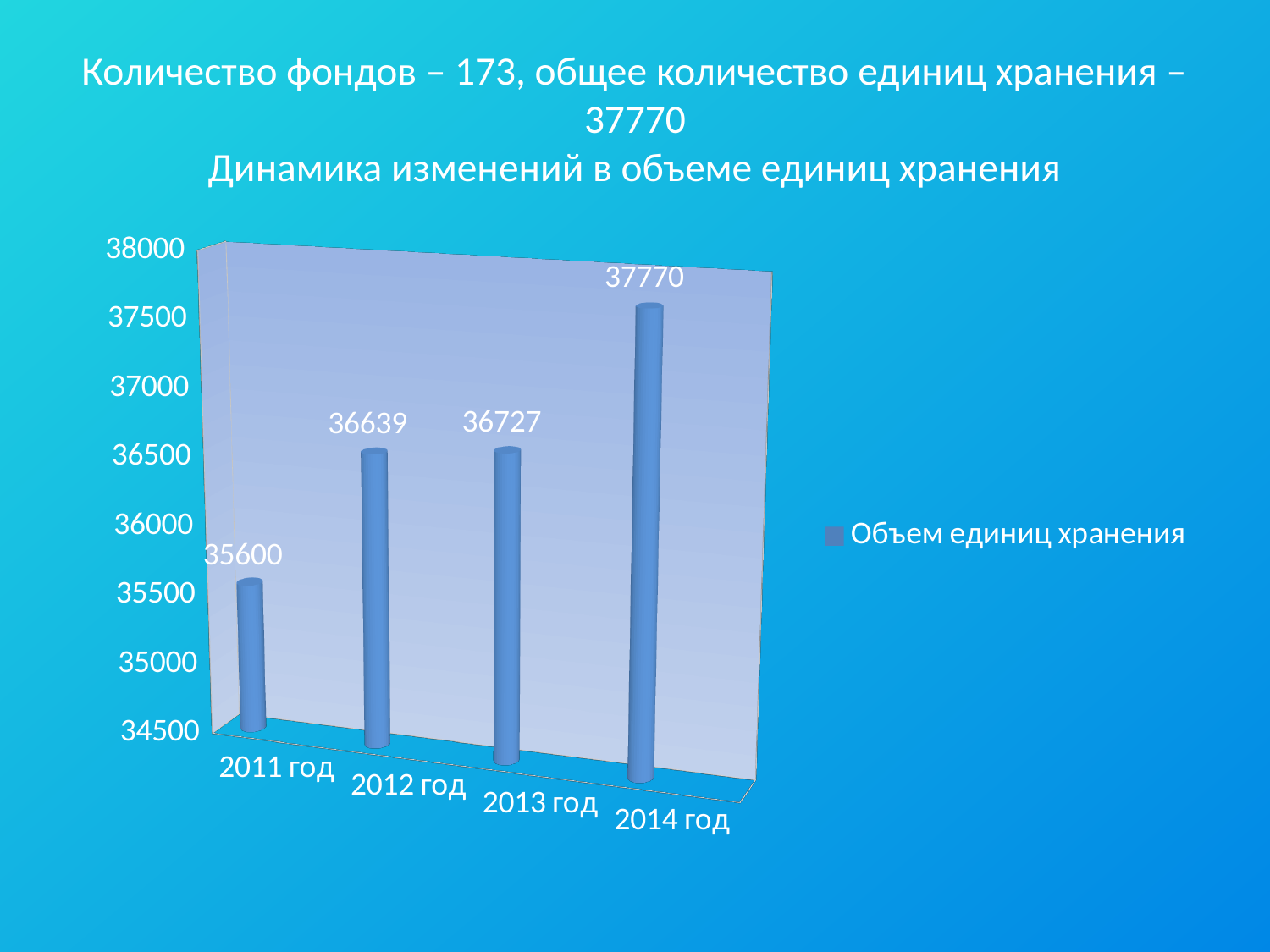
Which is larger, the value for 2012 год or the value for 2014 год? 2014 год What is the value for 2012 год? 36639 Which year has the highest value? 2014 год What is the value for 2013 год? 36727 What is the value for 2011 год? 35600 Which year has the lowest value? 2011 год What is the difference between the values for 2014 год and 2011 год? 2170 How many years are shown on the x axis? 4 What kind of chart is this? bar chart What is the difference between the values for 2013 год and 2012 год? 88 What is the value for 2014 год? 37770 Do the values rise or fall from 2011 год to 2014 год? rise